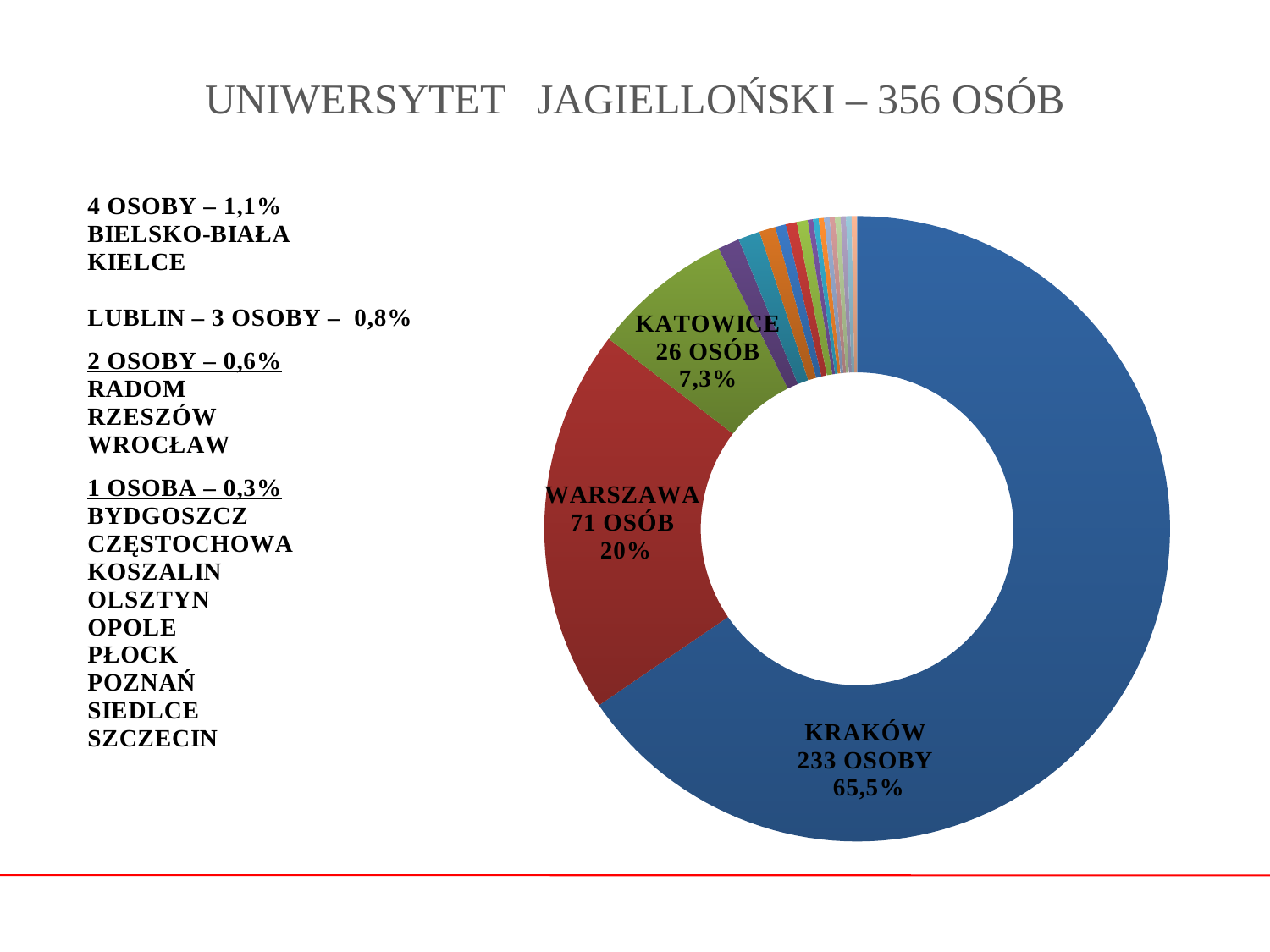
What kind of chart is shown on the slide? Doughnut (pie) chart What is the difference in number of people between Kraków and Warszawa? 162 How many people are shown for Katowice? 26 How many people (osoby) does the Kraków slice represent? 233 What is the total number of people given in the slide title? 356 What is the difference in number of people between Warszawa and Katowice? 45 What percentage share is shown for Katowice? 7,3% Which city has the largest slice of the chart? Kraków What colour is the Warszawa slice? Red What percentage share is shown for Kraków? 65,5% What percentage share is shown for Warszawa? 20% Which is larger, the slice for Warszawa or the slice for Katowice? Warszawa